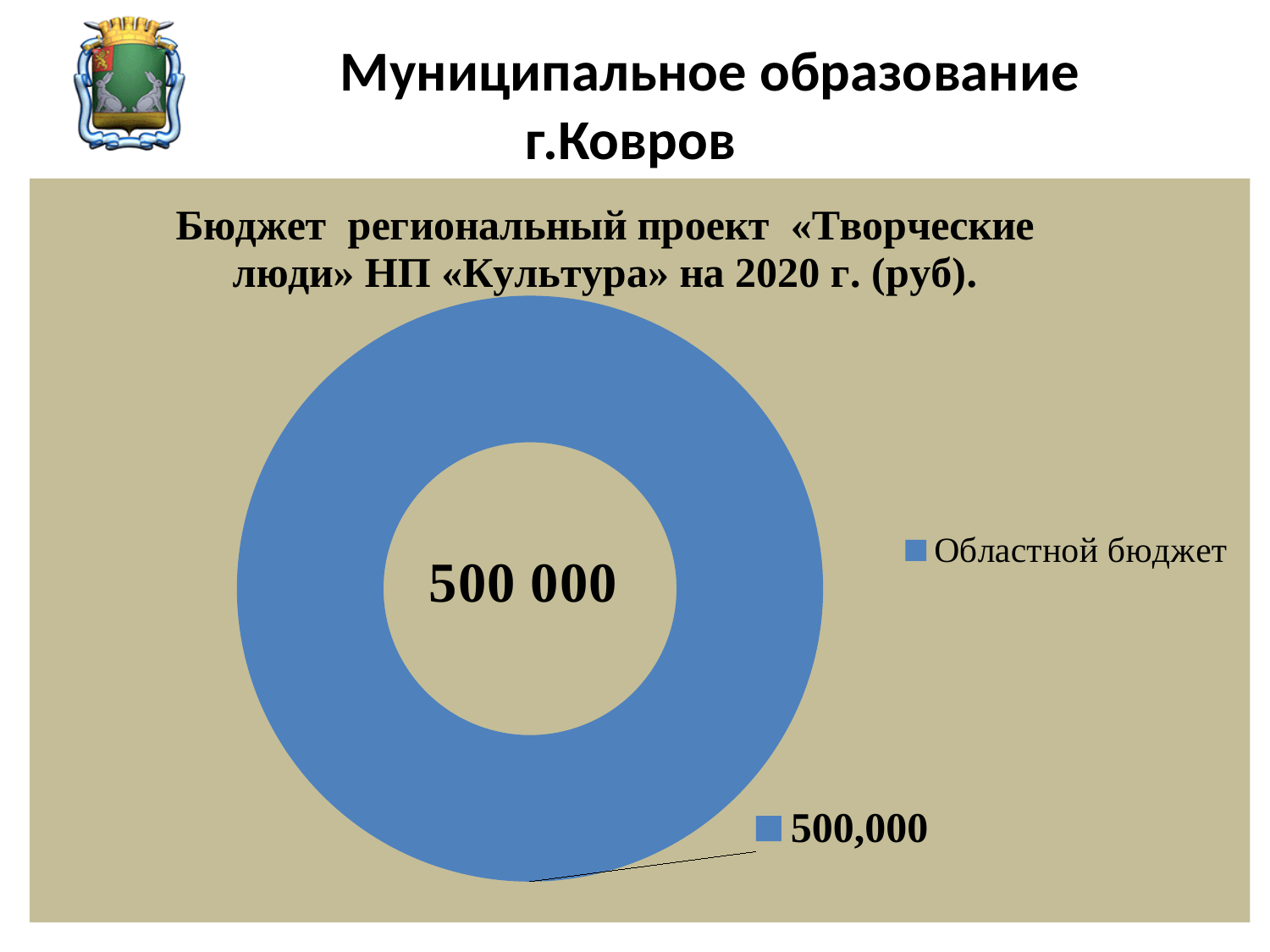
What kind of chart is shown on the slide? Doughnut chart How many entries does the legend list? 1 What share of the doughnut does Областной бюджет represent? 100% How many categories does the doughnut chart contain? 1 Is the value for Областной бюджет greater or less than 100,000? greater What is the title of the chart? Бюджет региональный проект «Творческие люди» НП «Культура» на 2020 г. (руб). What number is printed in the centre of the doughnut? 500 000 What is the total value of all slices in the doughnut chart? 500,000 What is the name of the only category in the legend? Областной бюджет What is the value shown for Областной бюджет? 500,000